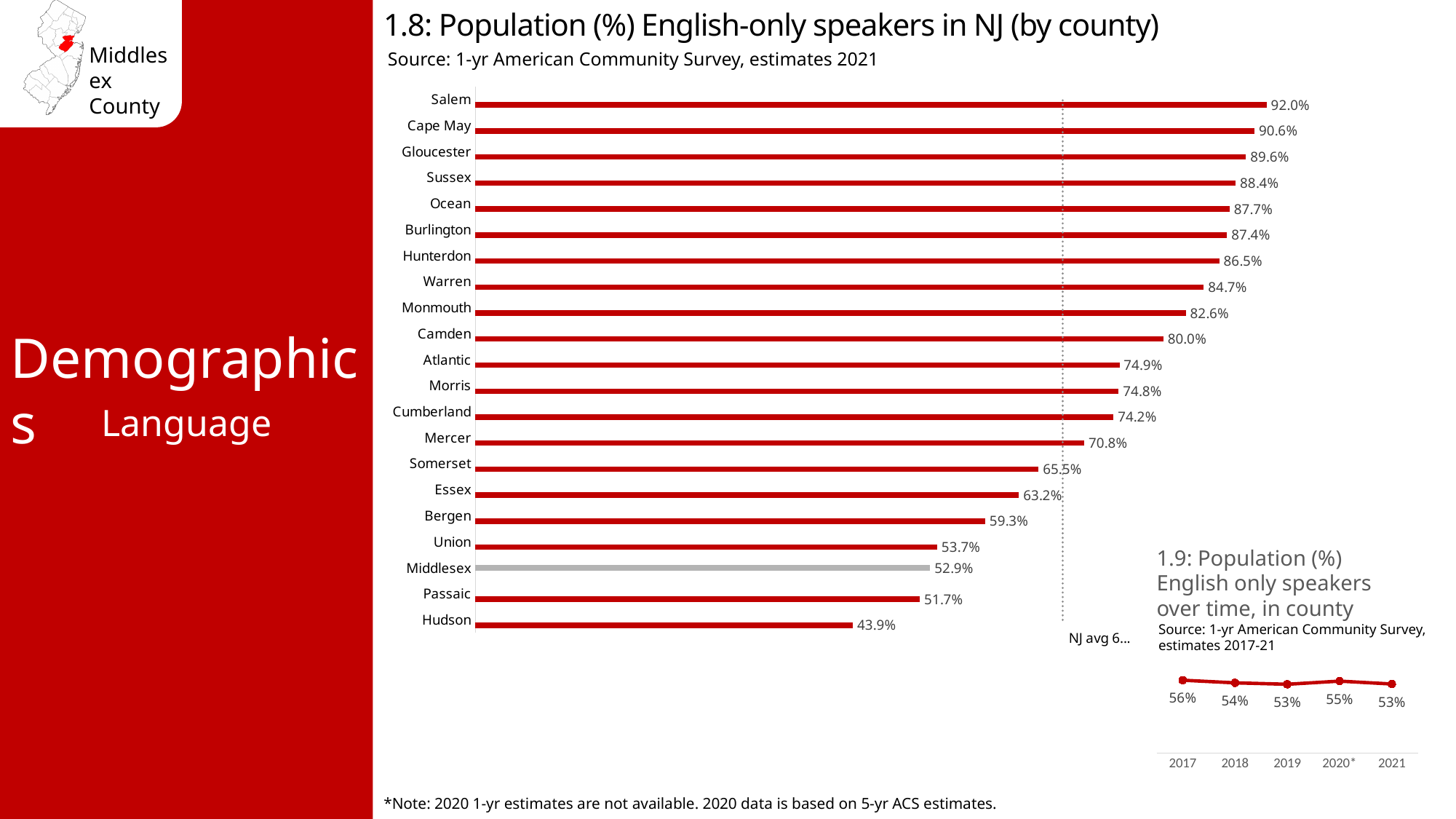
In chart 1.9, what is the difference between the values for 2017 and 2021? 3% In chart 1.8, which county has the highest percentage of English-only speakers? Salem In chart 1.9, what is the value for 2017? 56% In chart 1.8, what is the value for Middlesex? 52.9% In chart 1.8, which is larger, the value for Bergen or the value for Union? Bergen In chart 1.8, what is the value for Hunterdon? 86.5% In chart 1.8, which county's bar is shown in grey instead of red? Middlesex In chart 1.9, how many years are plotted? 5 In chart 1.8, what is the difference between the values for Salem and Hudson? 48.1% In chart 1.8, which county has the lowest percentage of English-only speakers? Hudson In chart 1.8, how many counties are shown? 21 What kind of chart is chart 1.8? Bar chart